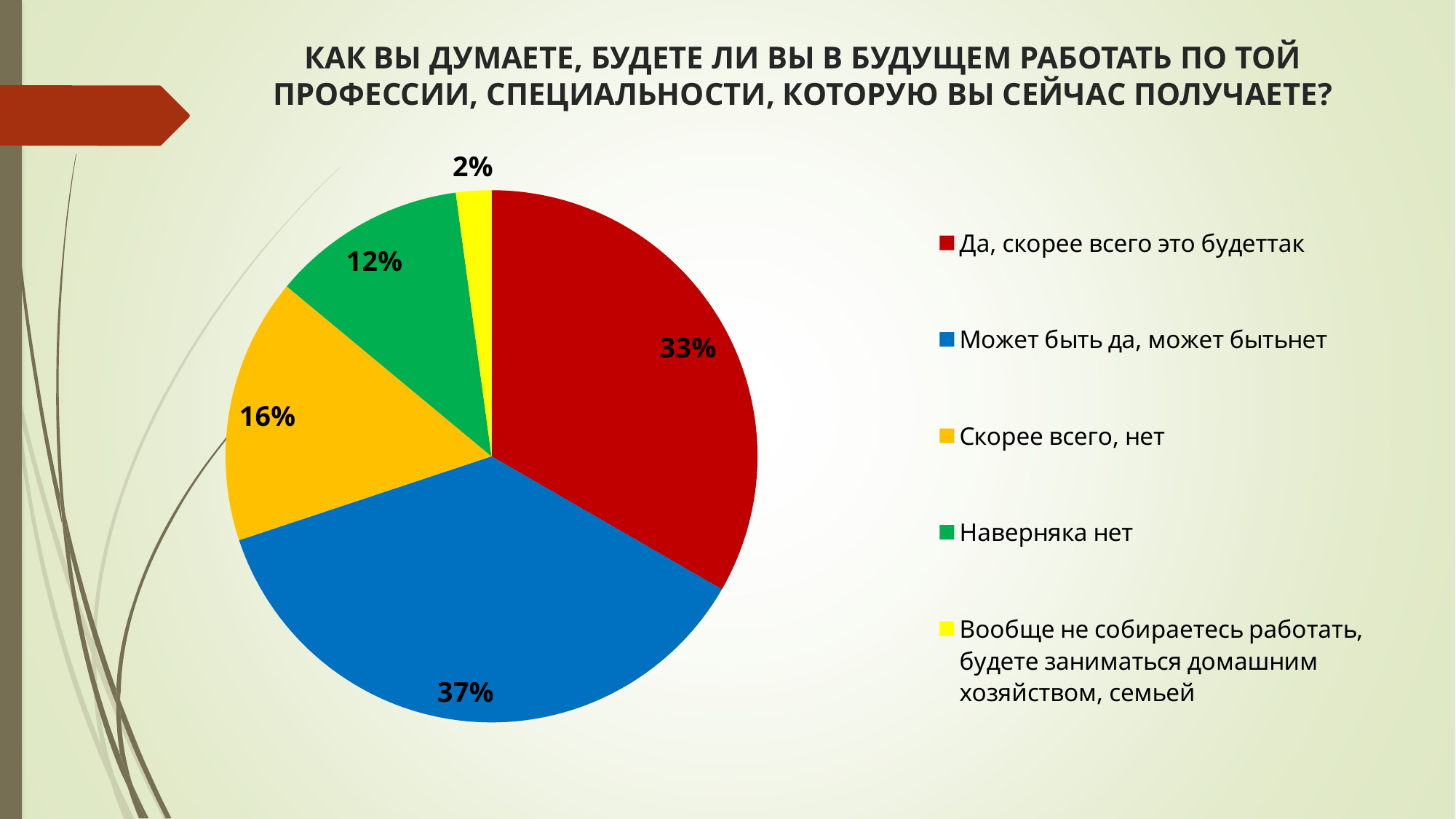
Which is larger: the share for "Скорее всего, нет" or the share for "Наверняка нет"? Скорее всего, нет Which answer option has the largest share of the pie? Может быть да, может быть нет What share of respondents answered "Наверняка нет"? 12% What is the difference in percentage points between "Может быть да, может быть нет" and "Да, скорее всего это будет так"? 4% What kind of chart is shown on the slide? pie chart What share of respondents answered "Может быть да, может быть нет"? 37% What share of respondents answered "Да, скорее всего это будет так"? 33% What colour is the slice for "Наверняка нет"? green How many answer options (slices) does the pie chart show? 5 What share of respondents said they do not intend to work at all and will take care of the household and family? 2% Which answer option has the smallest share of the pie? Вообще не собираетесь работать, будете заниматься домашним хозяйством, семьей What share of respondents answered "Скорее всего, нет"? 16%